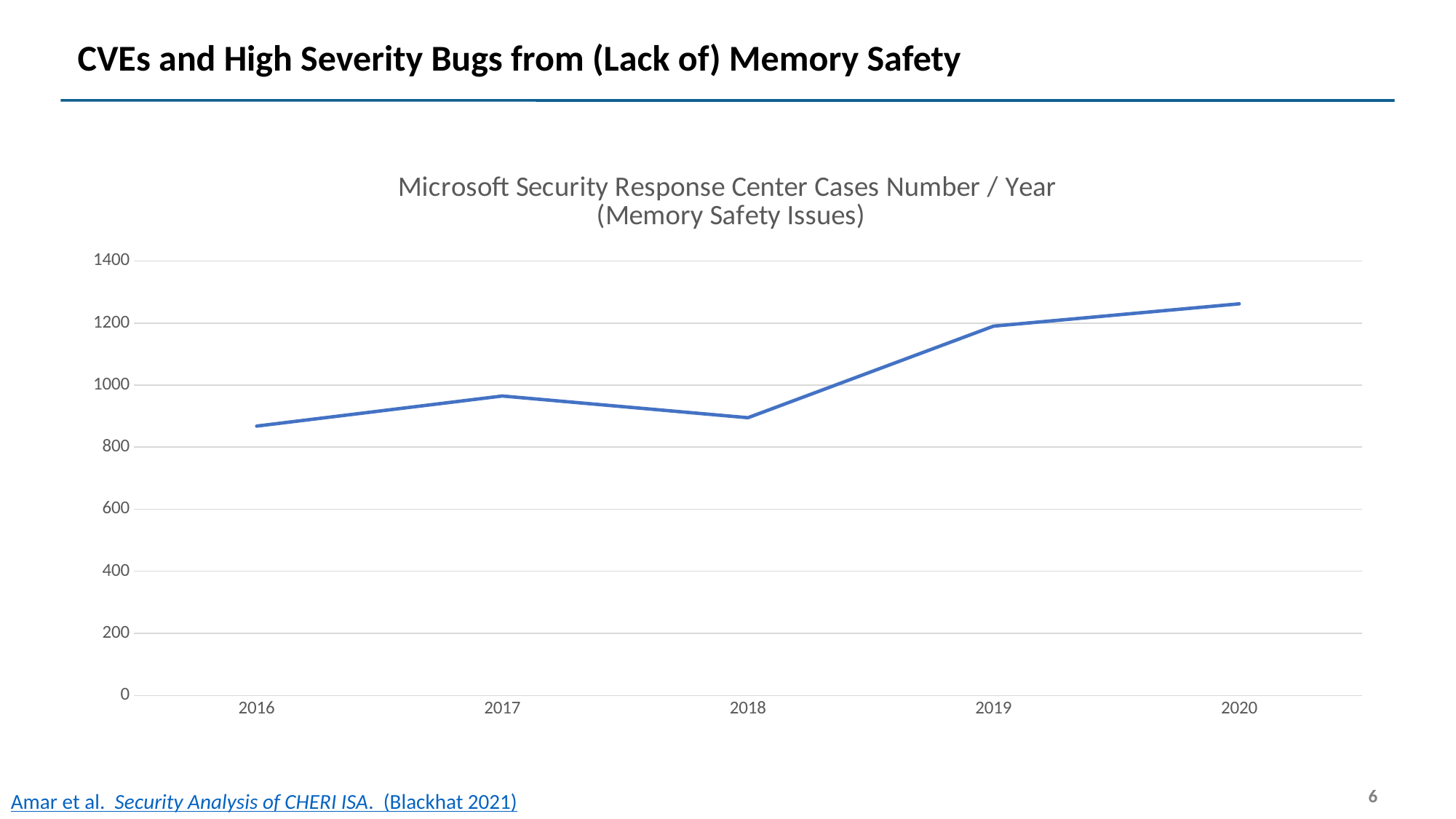
What is the title of the chart? Microsoft Security Response Center Cases Number / Year (Memory Safety Issues) Is the value for 2018 greater or less than 1000? less Which year has the larger value, 2019 or 2020? 2020 What kind of chart is shown on the slide? line chart Which year has the highest number of cases in the chart? 2020 How many years are plotted on the x axis of the chart? 5 Which year has the larger value, 2017 or 2018? 2017 Is the value for 2016 greater or less than 1000? less Is the value for 2017 greater or less than 800? greater Overall, do the values rise or fall from 2016 to 2020? rise